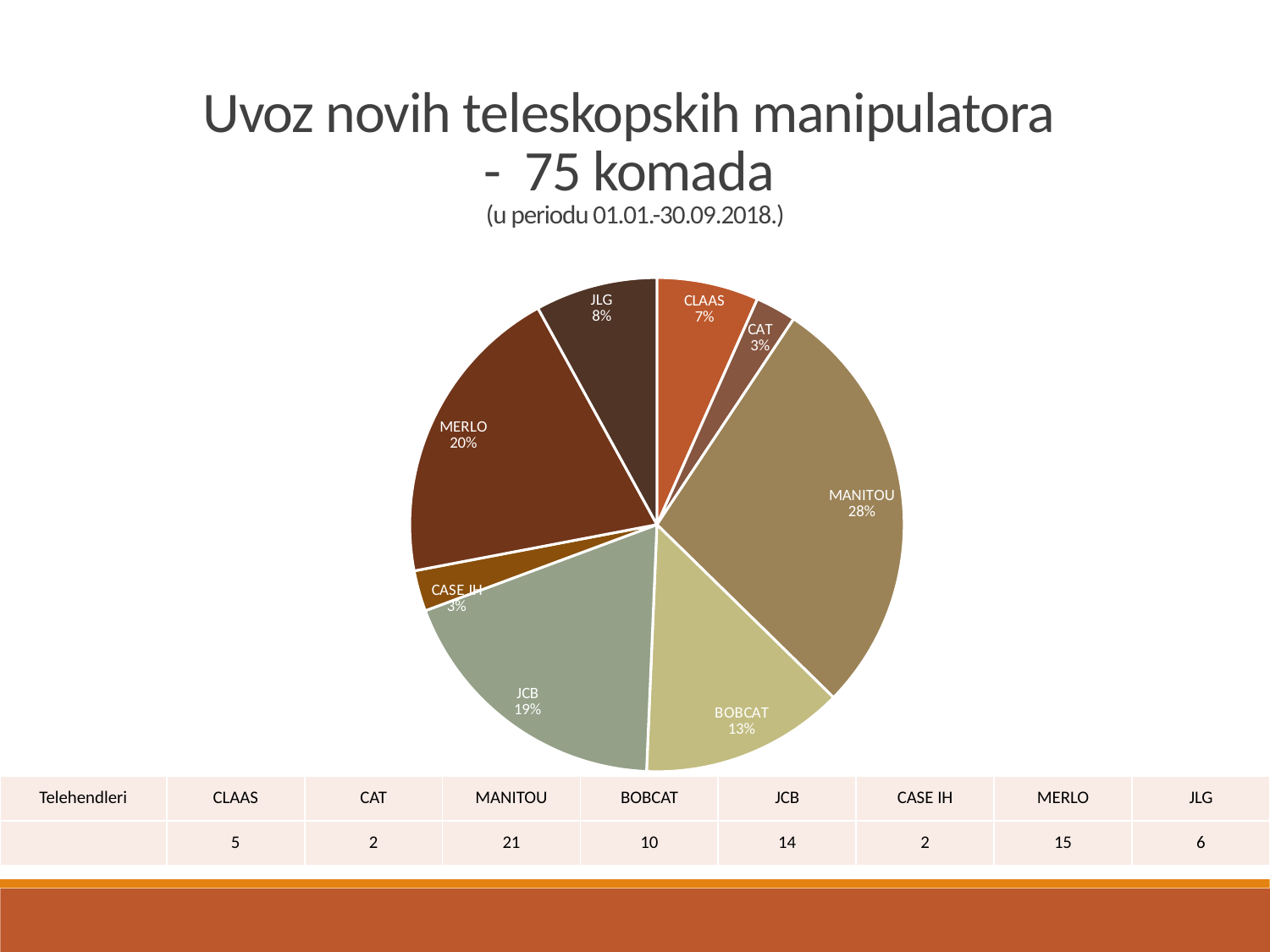
What share of the pie does JCB hold? 19% What share of the pie does BOBCAT hold? 13% What kind of chart is shown on the slide? pie chart What share of the pie does MANITOU hold? 28% How many slices does the pie chart have? 8 According to the table below the chart, how many MANITOU units were imported? 21 By how many percentage points does MANITOU's share exceed MERLO's share? 8 Which slice is larger, JCB or BOBCAT? JCB What total number of units does the chart title state? 75 komada Which brand has the largest slice of the pie? MANITOU